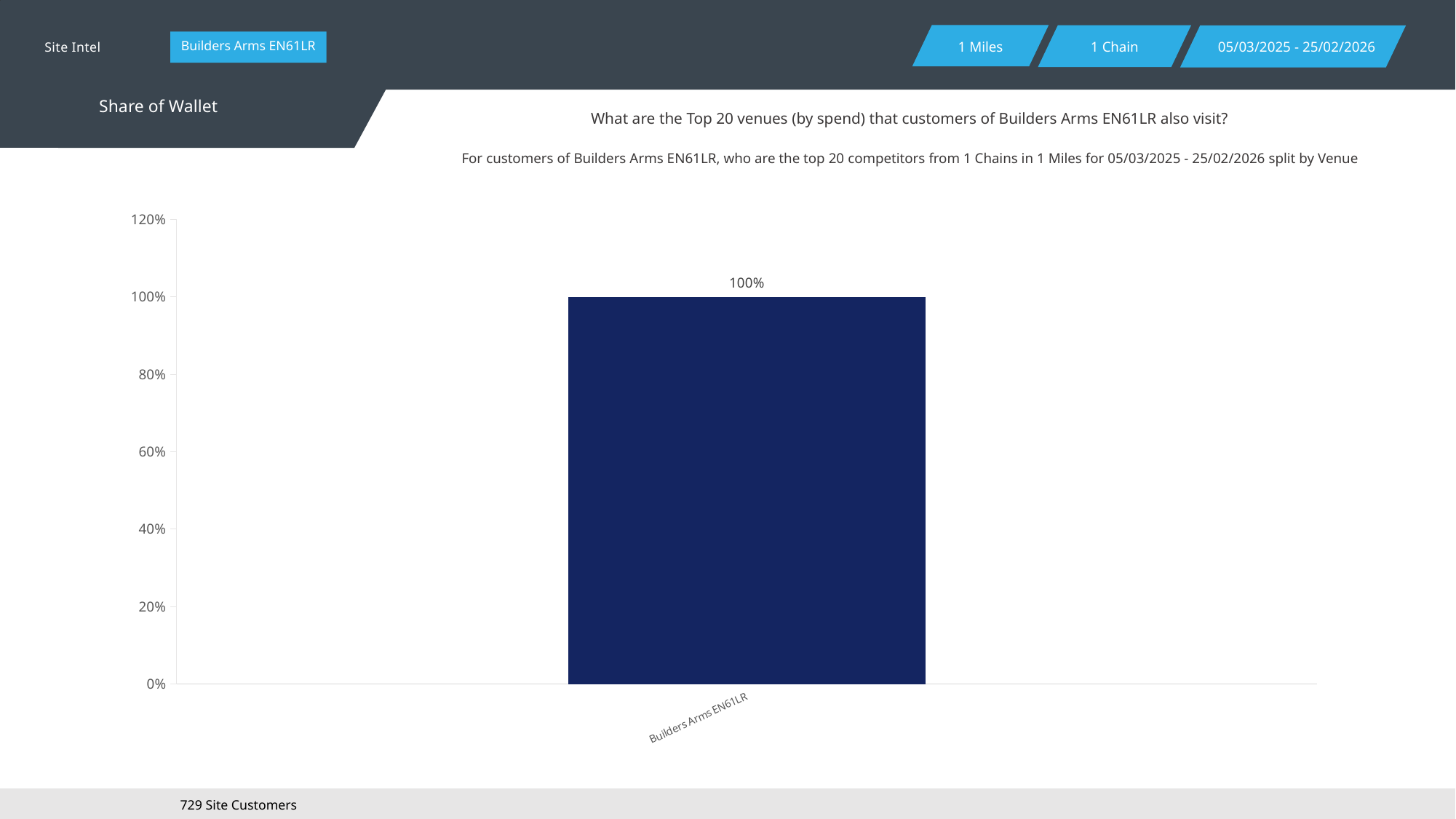
What kind of chart is shown on the slide? bar chart Is the value for Builders Arms EN61LR greater or less than 80%? greater Is the value for Builders Arms EN61LR greater or less than 120%? less Which category has the highest value on the chart? Builders Arms EN61LR How many categories are plotted on the chart? 1 What is the label of the only category on the x axis? Builders Arms EN61LR What is the value for Builders Arms EN61LR? 100% What is the highest value shown on the y axis? 120%